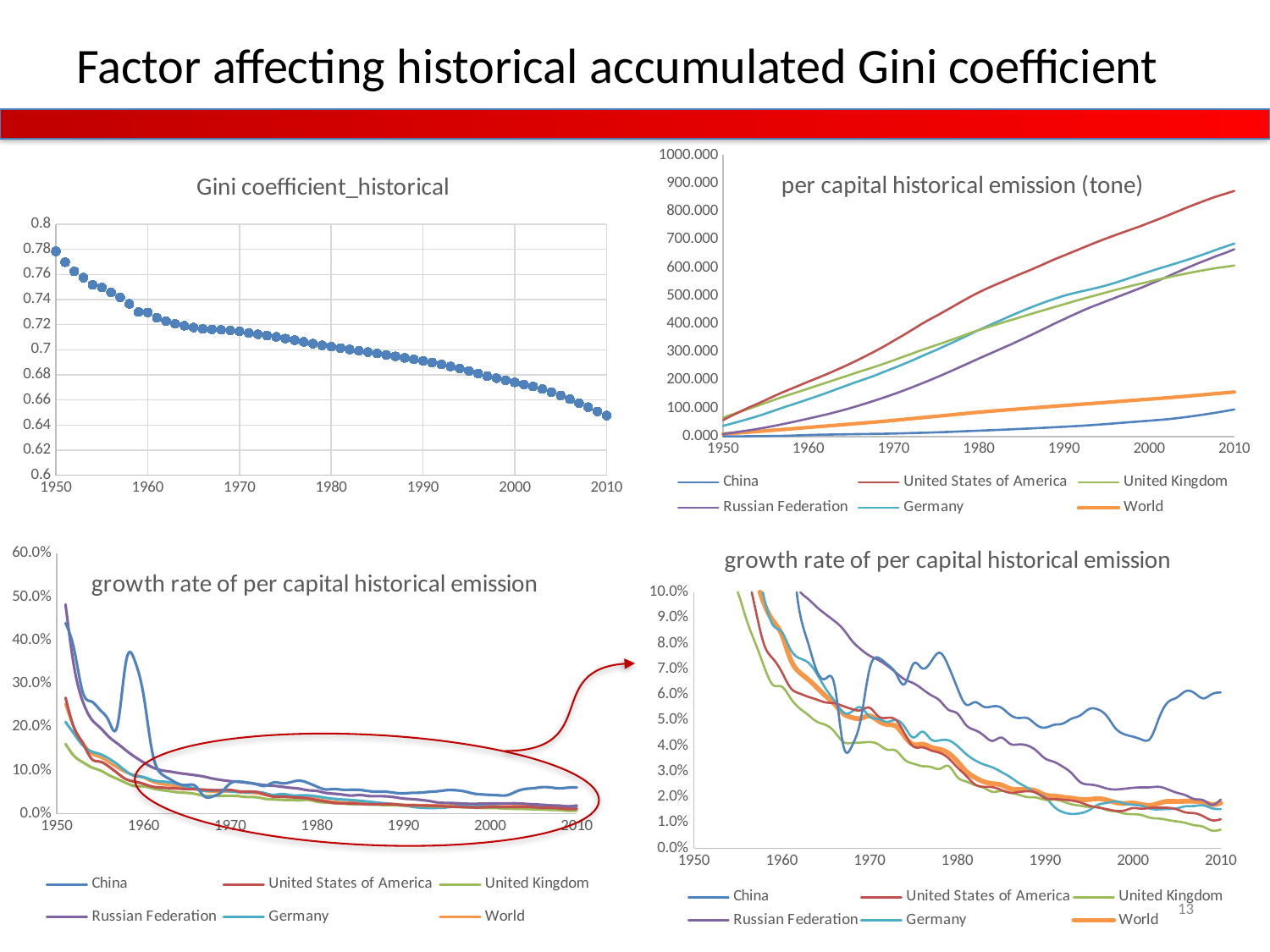
In the 'per capital historical emission (tone)' chart, which series has the highest value in 2010? United States of America What kind of chart is the 'Gini coefficient_historical' chart? Scatter chart with markers In the 'per capital historical emission (tone)' chart, which series has the lowest value in 2010? China In the 'Gini coefficient_historical' chart, do the values rise or fall from 1950 to 2010? Fall In the bottom-right 'growth rate of per capital historical emission' chart, is the value for China in 2010 greater or less than 5.0%? greater In the 'Gini coefficient_historical' chart, is the value for 1950 greater or less than 0.76? greater In the bottom-right 'growth rate of per capital historical emission' chart, which series has the lowest value in 2010? United Kingdom What kind of chart is the 'per capital historical emission (tone)' chart? Line chart How many series does the legend of the 'per capital historical emission (tone)' chart list? 6 In the 'per capital historical emission (tone)' chart, which is larger in 2010: United States of America or United Kingdom? United States of America In the 'per capital historical emission (tone)' chart, is the value for United States of America in 2010 greater or less than 800.000? greater